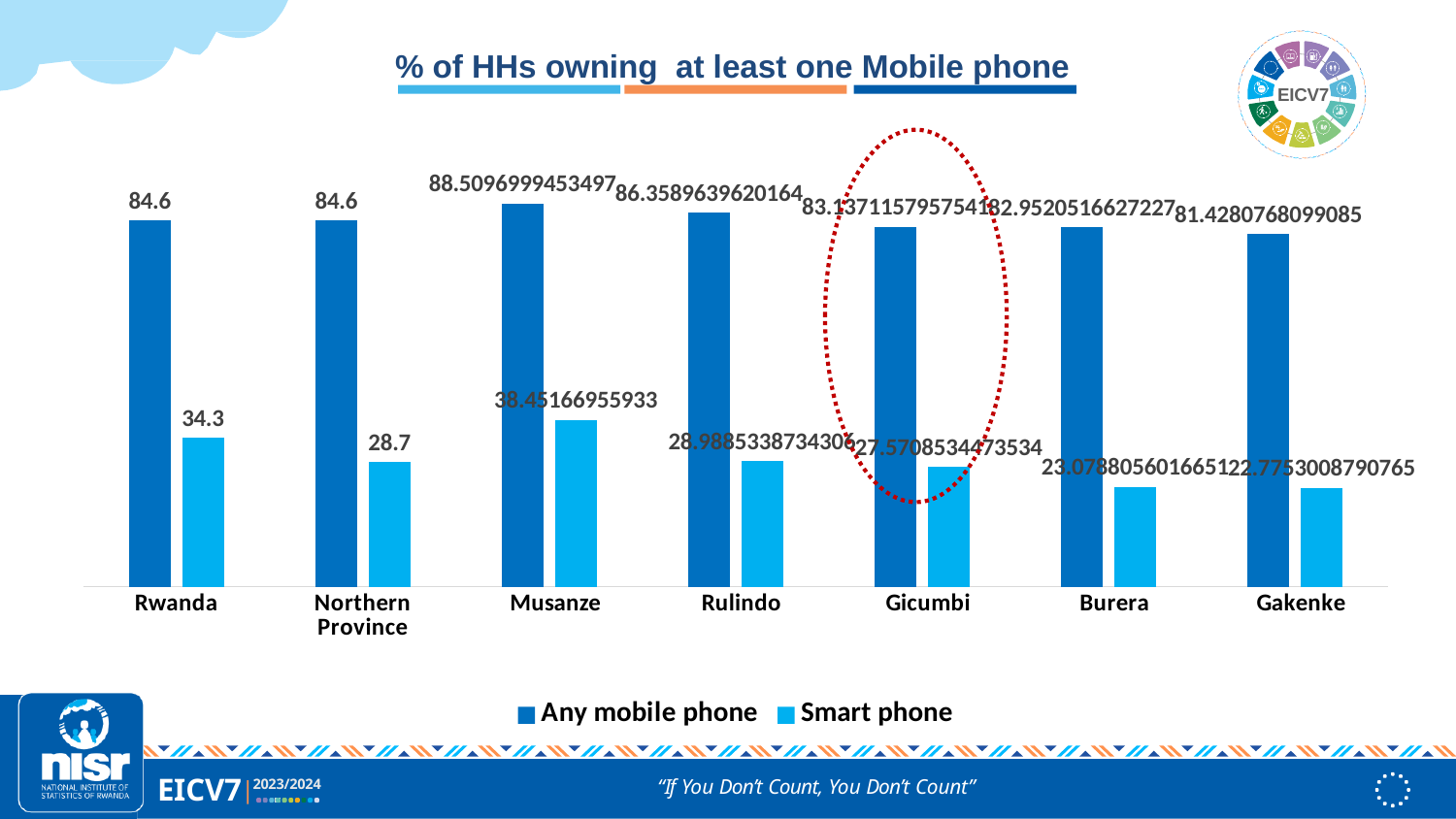
What is the value for Smart phone in Musanze? 38.45166955933 How many categories are shown on the x axis? 7 What is the value for Any mobile phone in Rwanda? 84.6 What is the title of the chart? % of HHs owning at least one Mobile phone What is the difference between Any mobile phone and Smart phone in Rwanda? 50.3 What is the value for Smart phone in Northern Province? 28.7 What type of chart is shown on the slide? Bar chart Which category has the highest value for Any mobile phone? Musanze Which is larger, the Smart phone value for Rwanda or for Northern Province? Rwanda Which category has the highest value for Smart phone? Musanze How many series does the legend list? 2 What is the value for Any mobile phone in Gakenke? 81.4280768099085